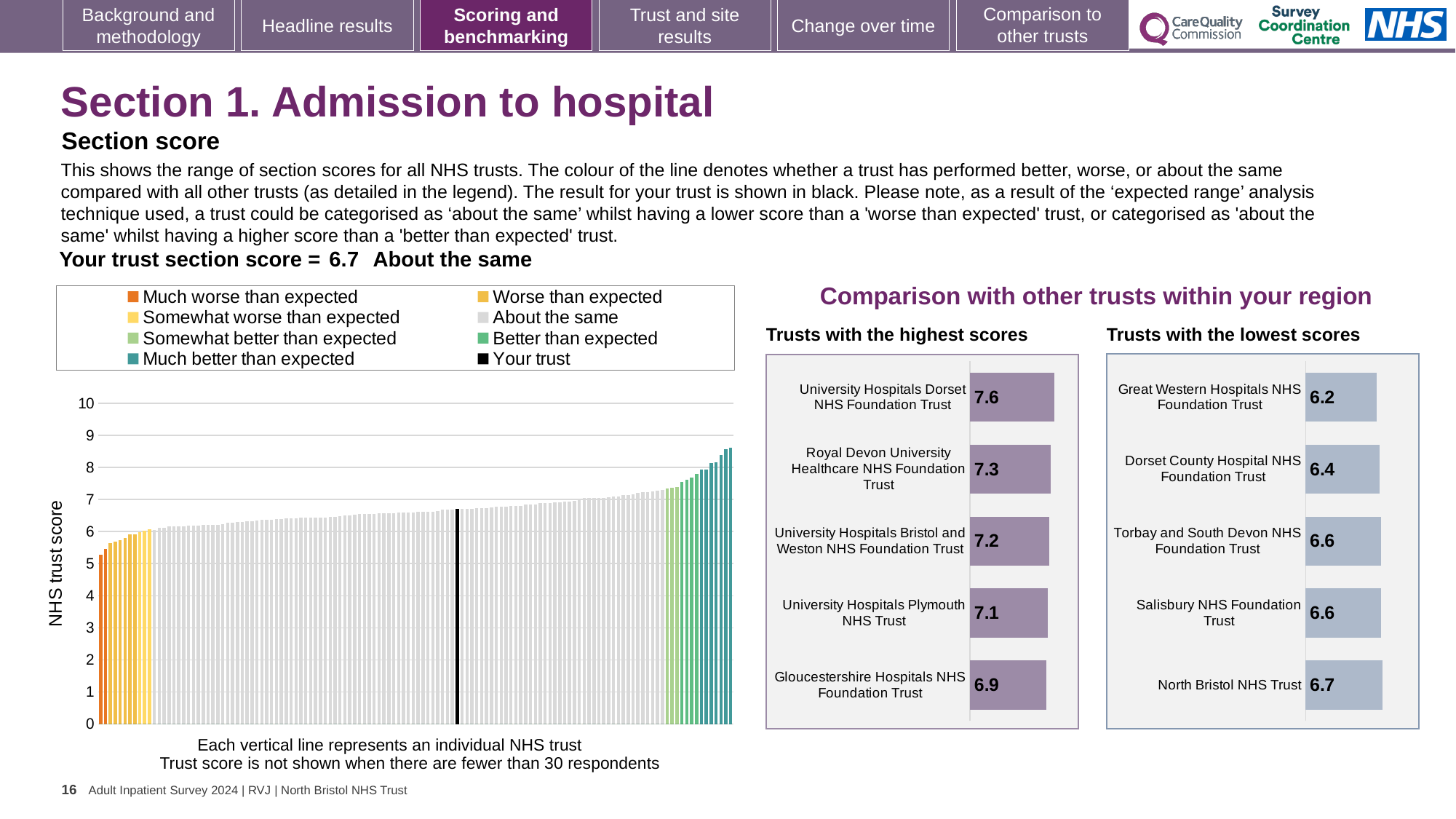
In the 'Trusts with the lowest scores' chart, which has the higher score: Dorset County Hospital NHS Foundation Trust or Torbay and South Devon NHS Foundation Trust? Torbay and South Devon NHS Foundation Trust In the 'Trusts with the lowest scores' chart, what is the score for Great Western Hospitals NHS Foundation Trust? 6.2 In the 'NHS trust score' chart on the left, do the values rise or fall from left to right? Rise In the 'Trusts with the highest scores' chart, what is the score for University Hospitals Dorset NHS Foundation Trust? 7.6 How many entries does the legend of the 'NHS trust score' chart on the left list? 8 In the 'Trusts with the highest scores' chart, what is the difference between the scores of University Hospitals Dorset NHS Foundation Trust and Gloucestershire Hospitals NHS Foundation Trust? 0.7 What kind of chart is the 'NHS trust score' chart on the left of the slide? Bar chart In the 'Trusts with the highest scores' chart, which trust has the highest score? University Hospitals Dorset NHS Foundation Trust In the 'NHS trust score' chart on the left, what is the section score for your trust (the black bar)? 6.7 In the 'Trusts with the lowest scores' chart, what is the difference between the scores of North Bristol NHS Trust and Great Western Hospitals NHS Foundation Trust? 0.5 How many trusts are shown in the 'Trusts with the highest scores' chart? 5 In the 'Trusts with the lowest scores' chart, which trust has the lowest score? Great Western Hospitals NHS Foundation Trust